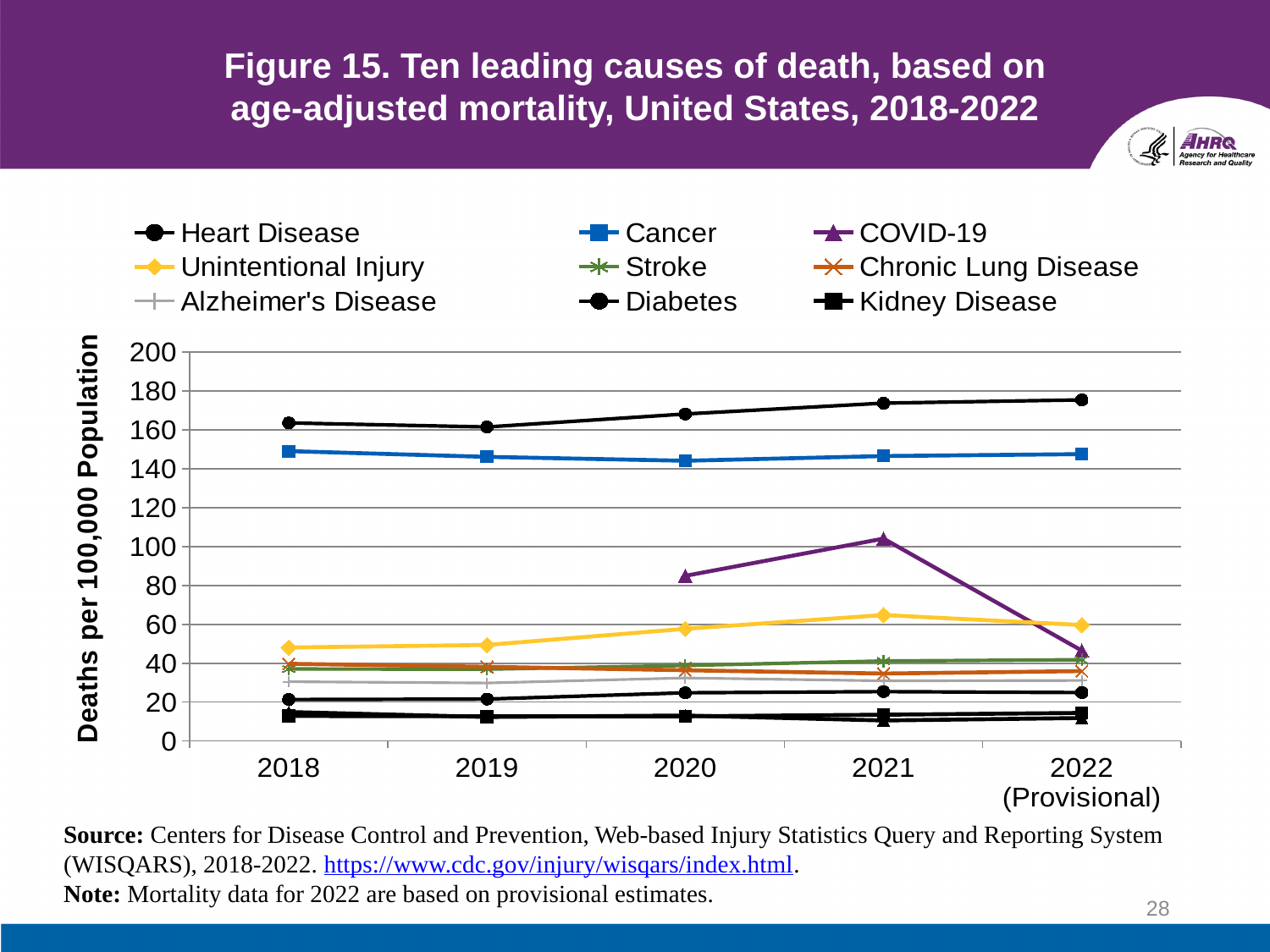
Which cause of death has the highest age-adjusted mortality rate in 2022 (Provisional)? Heart Disease What kind of chart is shown on the slide? line chart Is the value for COVID-19 in 2021 greater or less than 100? greater How many years are shown along the x axis? 5 What is the label on the y axis? Deaths per 100,000 Population Which is larger in 2020, the value for COVID-19 or the value for Unintentional Injury? COVID-19 Is the value for Unintentional Injury in 2022 (Provisional) greater or less than 40? greater Is the value for Cancer in 2020 greater or less than 160? less How many series does the legend list? 9 Which cause of death has the lowest age-adjusted mortality rate in 2018? Kidney Disease Does the COVID-19 line rise or fall between 2021 and 2022 (Provisional)? fall